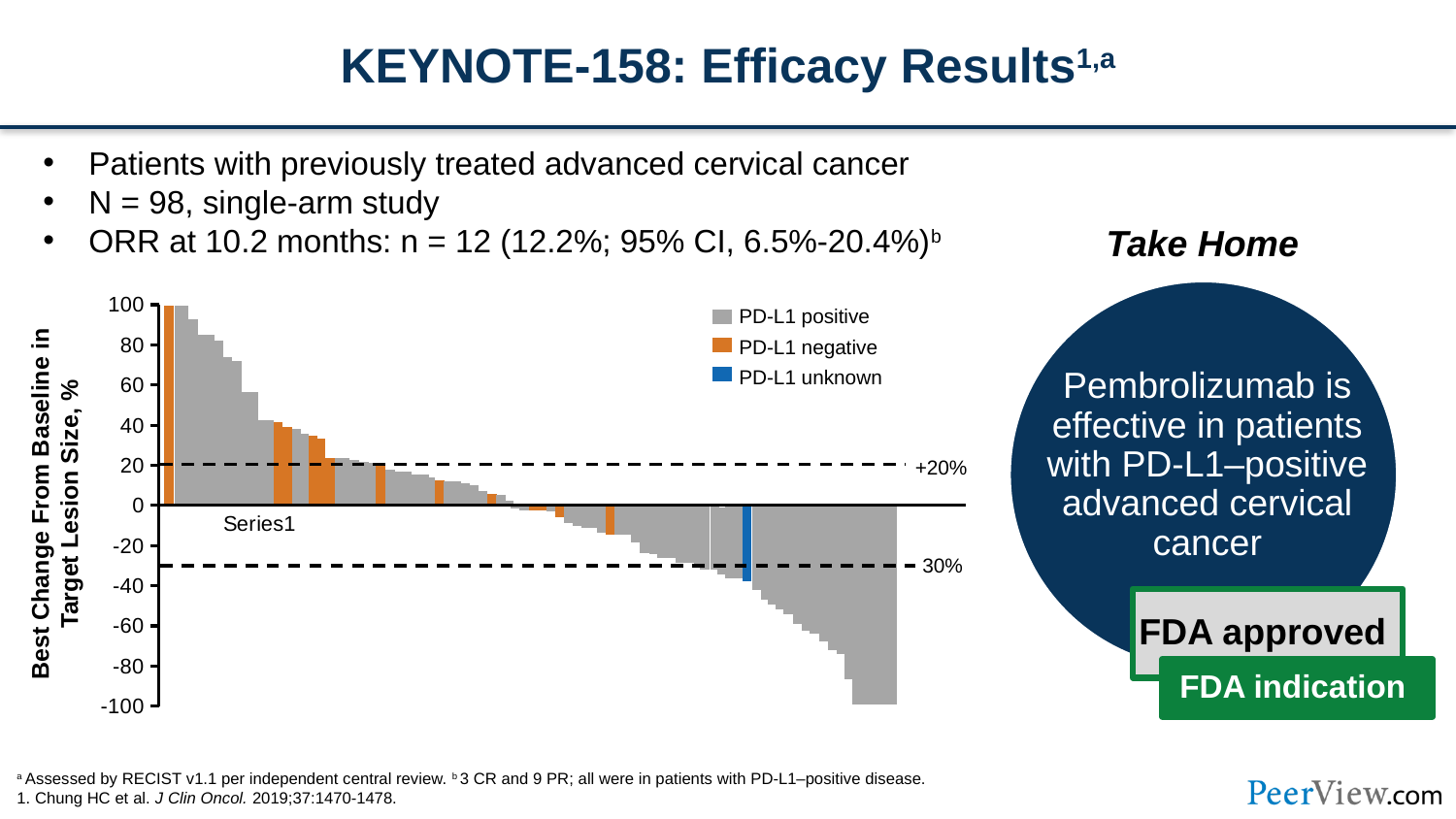
What kind of chart is shown on the slide? Bar chart Is the value of the rightmost bar greater or less than -80? less Is the PD-L1 unknown bar above or below zero? Below Is the value of the PD-L1 unknown (blue) bar greater or less than -20? less How many series does the chart legend list? 3 What value does the upper dashed reference line mark? +20% What are the three entries in the chart legend? PD-L1 positive, PD-L1 negative, PD-L1 unknown How many PD-L1 unknown bars are plotted in the chart? 1 What value does the lower dashed reference line mark? 30% Do the bar values rise or fall moving from left to right along the x axis? Fall What is the label of the chart's vertical axis? Best Change From Baseline in Target Lesion Size, % Is the value of the leftmost bar greater or less than 80? greater